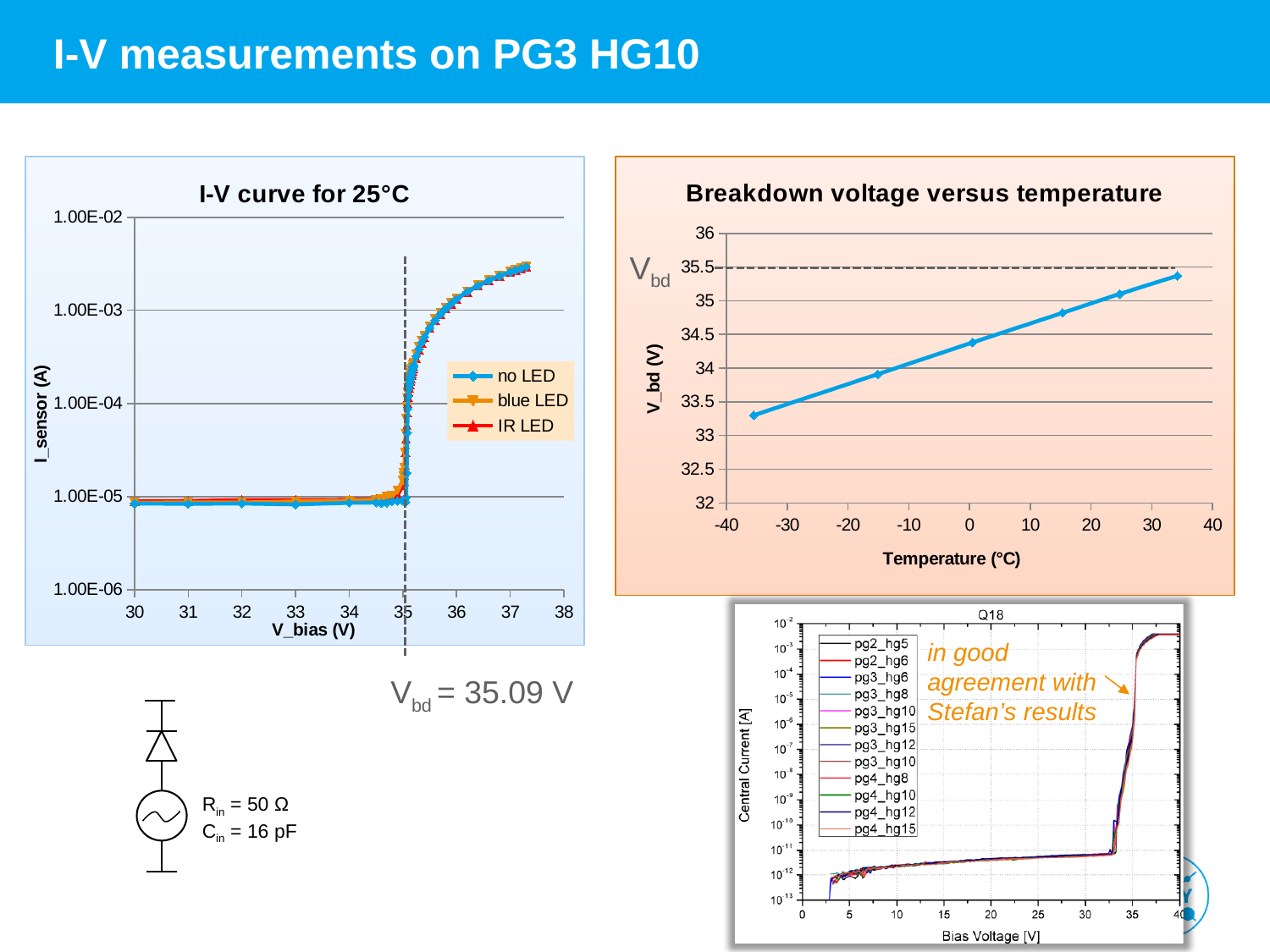
In the 'Q18' chart at the bottom right, how many series does the legend list? 12 In the 'I-V curve for 25°C' chart, is the 'no LED' current at V_bias = 32 V greater or less than 1.00E-04 A? less In the 'Breakdown voltage versus temperature' chart, does V_bd rise or fall as temperature increases? rise In the 'I-V curve for 25°C' chart, is the 'no LED' current at V_bias = 37 V greater or less than 1.00E-03 A? greater In the 'I-V curve for 25°C' chart, what breakdown voltage V_bd is marked by the dashed vertical line? 35.09 V In the 'Breakdown voltage versus temperature' chart, is the V_bd value at the lowest temperature point (about -35°C) greater or less than 33.5 V? less In the 'Breakdown voltage versus temperature' chart, how many data points are plotted? 6 In the 'I-V curve for 25°C' chart, does I_sensor rise or fall as V_bias increases from 35 V to 38 V? rise In the 'I-V curve for 25°C' chart, how many series does the legend list? 3 What kind of chart is the 'I-V curve for 25°C' chart? line chart What is the x-axis label of the 'Q18' chart at the bottom right? Bias Voltage [V]